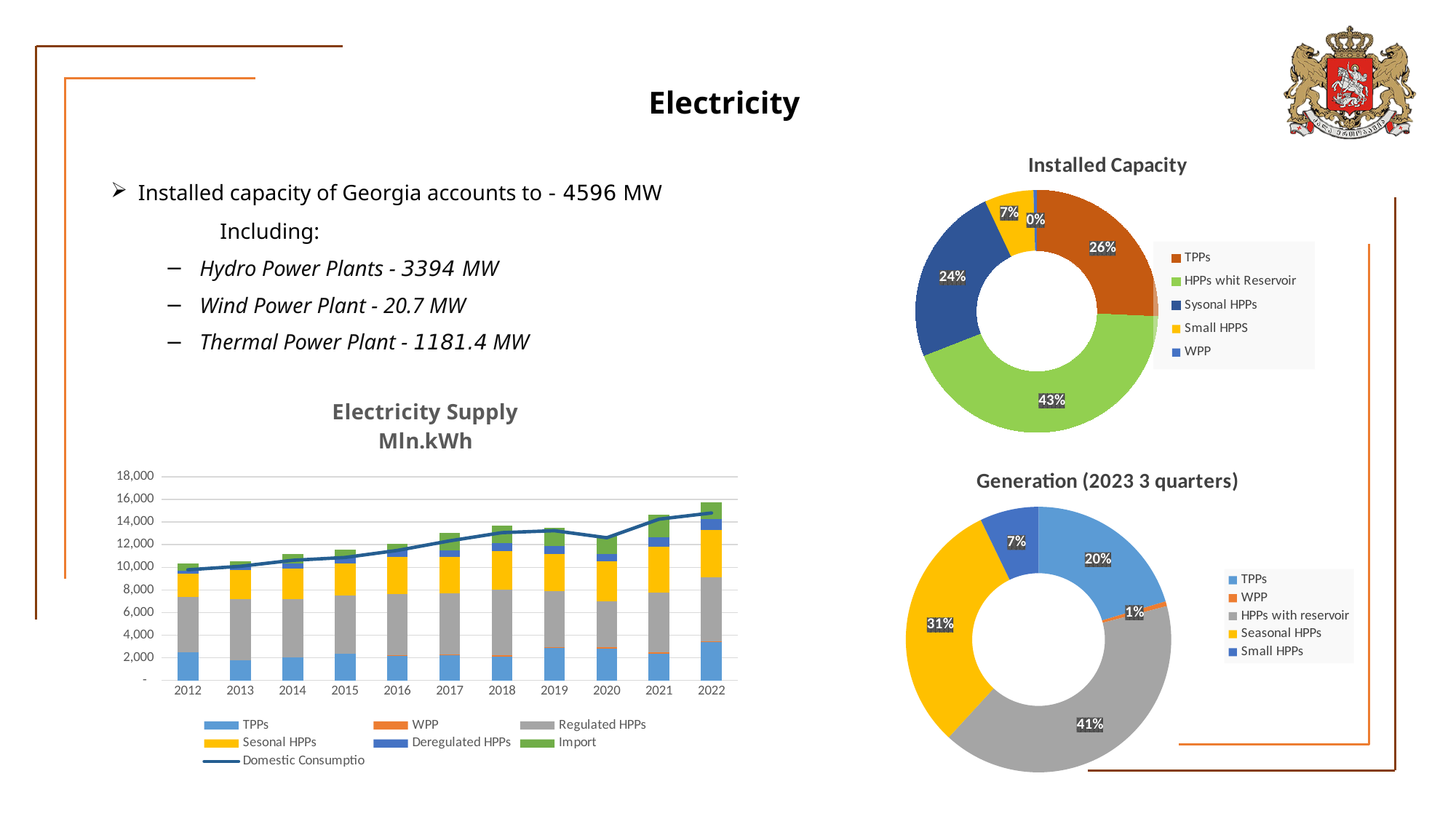
In the Generation (2023 3 quarters) chart, which is larger, the share for TPPs or the share for Small HPPs? TPPs In the Generation (2023 3 quarters) chart, what share does Seasonal HPPs have? 31% In the Electricity Supply Mln.kWh chart, is the total stacked value for 2022 greater or less than 14,000? greater In the Generation (2023 3 quarters) chart, which category has the smallest share? WPP What kind of chart is the Electricity Supply Mln.kWh chart? Stacked bar chart with a line In the Installed Capacity chart, what share does HPPs whit Reservoir have? 43% In the Installed Capacity chart, what is the difference between the TPPs share and the Small HPPS share? 19% In the Electricity Supply Mln.kWh chart, does the Domestic Consumption line generally rise or fall from 2012 to 2022? rise In the Installed Capacity chart, which category has the largest share? HPPs whit Reservoir How many categories does the legend of the Generation (2023 3 quarters) chart list? 5 How many years are shown on the x axis of the Electricity Supply Mln.kWh chart? 11 In the Installed Capacity chart, what share does Sysonal HPPs have? 24%